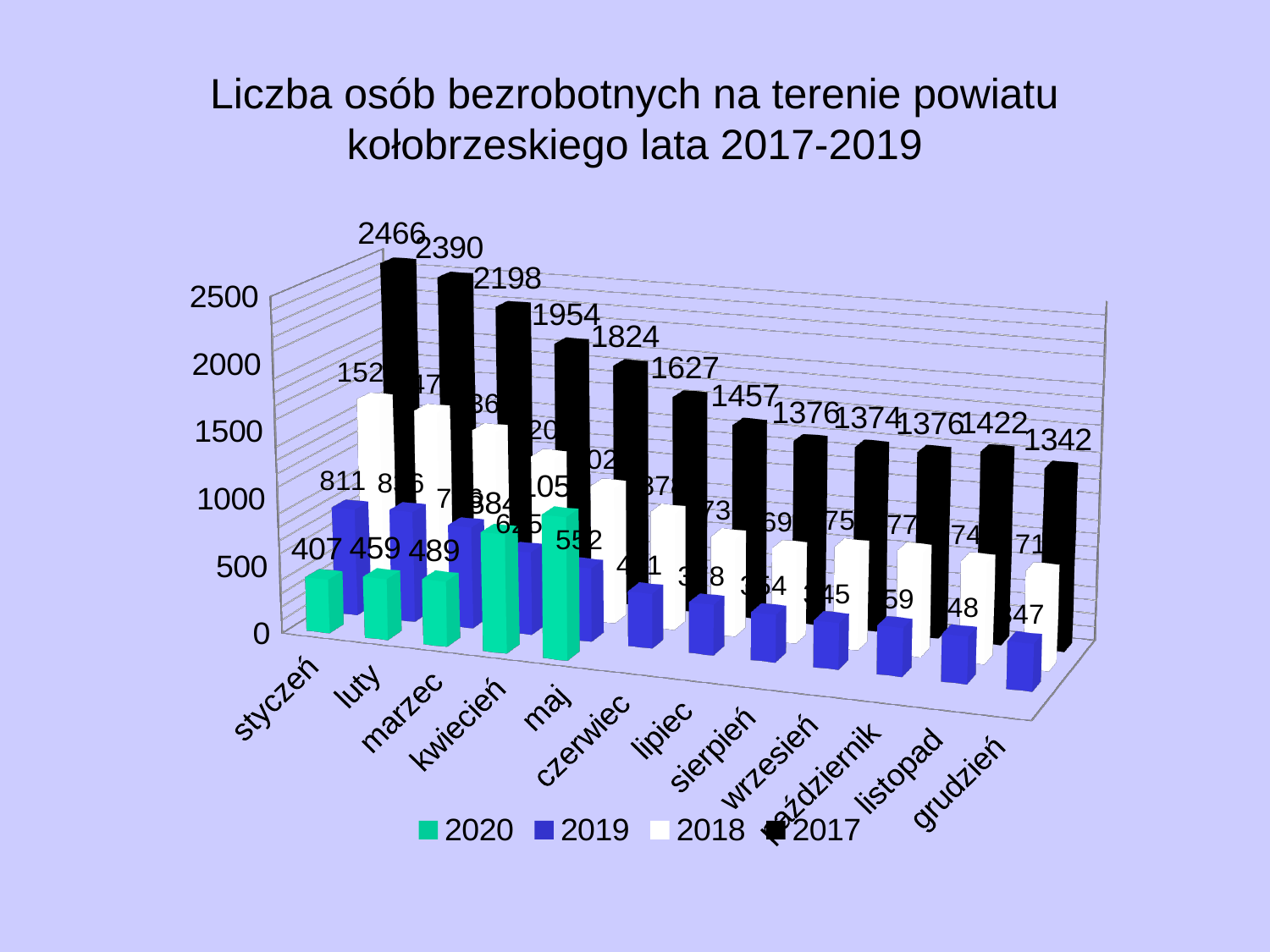
How many months are shown on the x axis? 12 What is the value for 2017 in grudzień? 1342 Do the 2017 values generally rise or fall from styczeń to grudzień? fall What is the difference between the 2017 values for styczeń and luty? 76 What is the value for 2020 in styczeń? 407 What kind of chart is shown on the slide? bar chart How many series does the legend list? 4 What is the value for 2017 in lipiec? 1457 Which is larger for 2017: listopad or grudzień? listopad What is the value for 2017 in styczeń? 2466 In which month is the 2017 value lowest? grudzień In which month is the 2017 value highest? styczeń